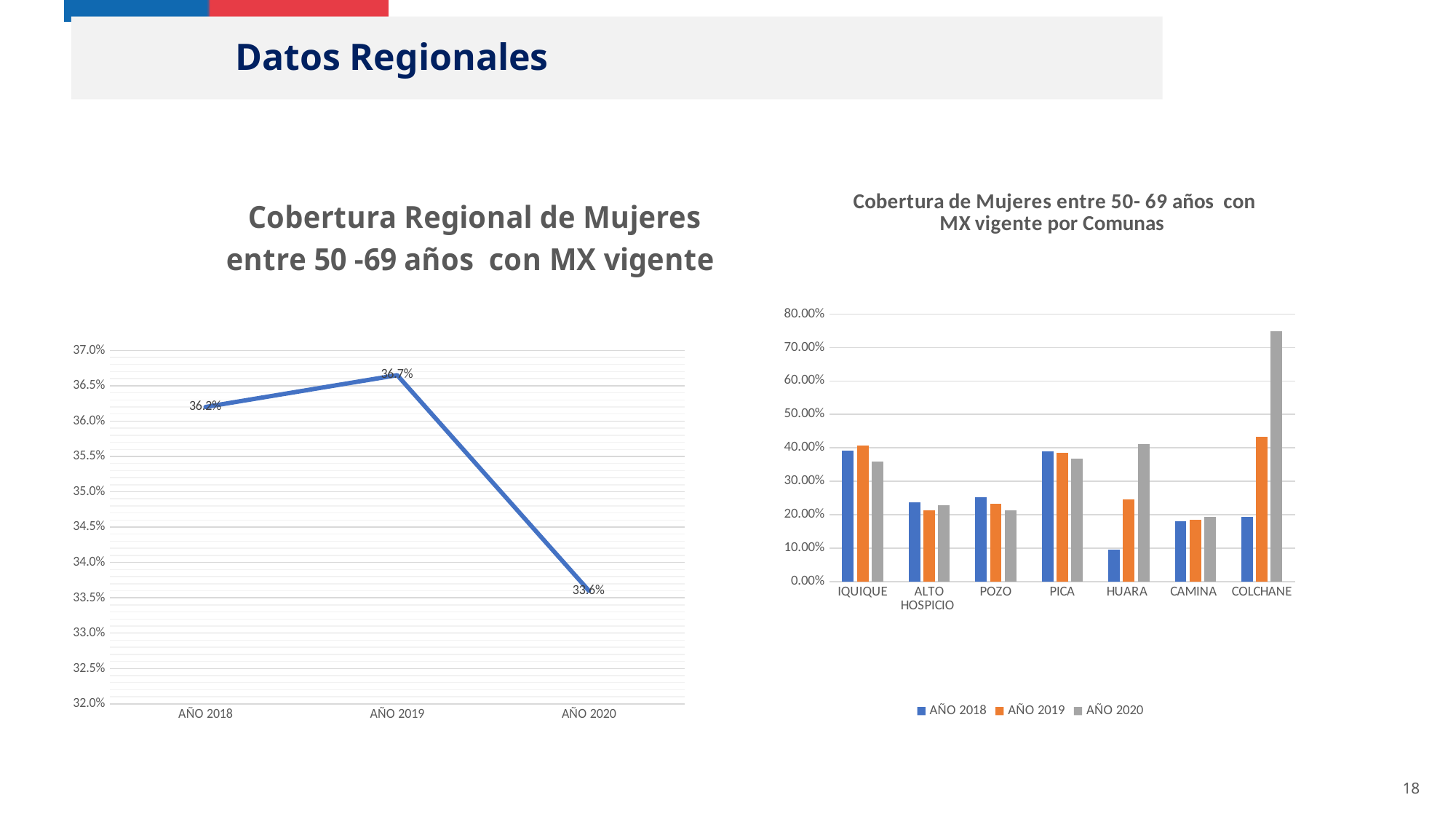
In the left chart 'Cobertura Regional de Mujeres entre 50 -69 años con MX vigente', what is the value for AÑO 2019? 36.7% What kind of chart is the right chart 'Cobertura de Mujeres entre 50- 69 años con MX vigente por Comunas'? bar chart How many comunas are shown on the x axis of the right chart 'Cobertura de Mujeres entre 50- 69 años con MX vigente por Comunas'? 7 In the left chart 'Cobertura Regional de Mujeres entre 50 -69 años con MX vigente', how many data points are plotted? 3 In the right chart 'Cobertura de Mujeres entre 50- 69 años con MX vigente por Comunas', is the AÑO 2020 value for COLCHANE greater or less than 70.00%? greater How many series does the legend of the right chart 'Cobertura de Mujeres entre 50- 69 años con MX vigente por Comunas' list? 3 In the left chart 'Cobertura Regional de Mujeres entre 50 -69 años con MX vigente', which year has the lowest value? AÑO 2020 In the right chart 'Cobertura de Mujeres entre 50- 69 años con MX vigente por Comunas', which comuna has the highest AÑO 2020 value? COLCHANE What kind of chart is the left chart 'Cobertura Regional de Mujeres entre 50 -69 años con MX vigente'? line chart In the left chart 'Cobertura Regional de Mujeres entre 50 -69 años con MX vigente', what is the value for AÑO 2020? 33.6% In the left chart 'Cobertura Regional de Mujeres entre 50 -69 años con MX vigente', what is the difference between the values for AÑO 2019 and AÑO 2020? 3.1% In the left chart 'Cobertura Regional de Mujeres entre 50 -69 años con MX vigente', which year has the highest value? AÑO 2019